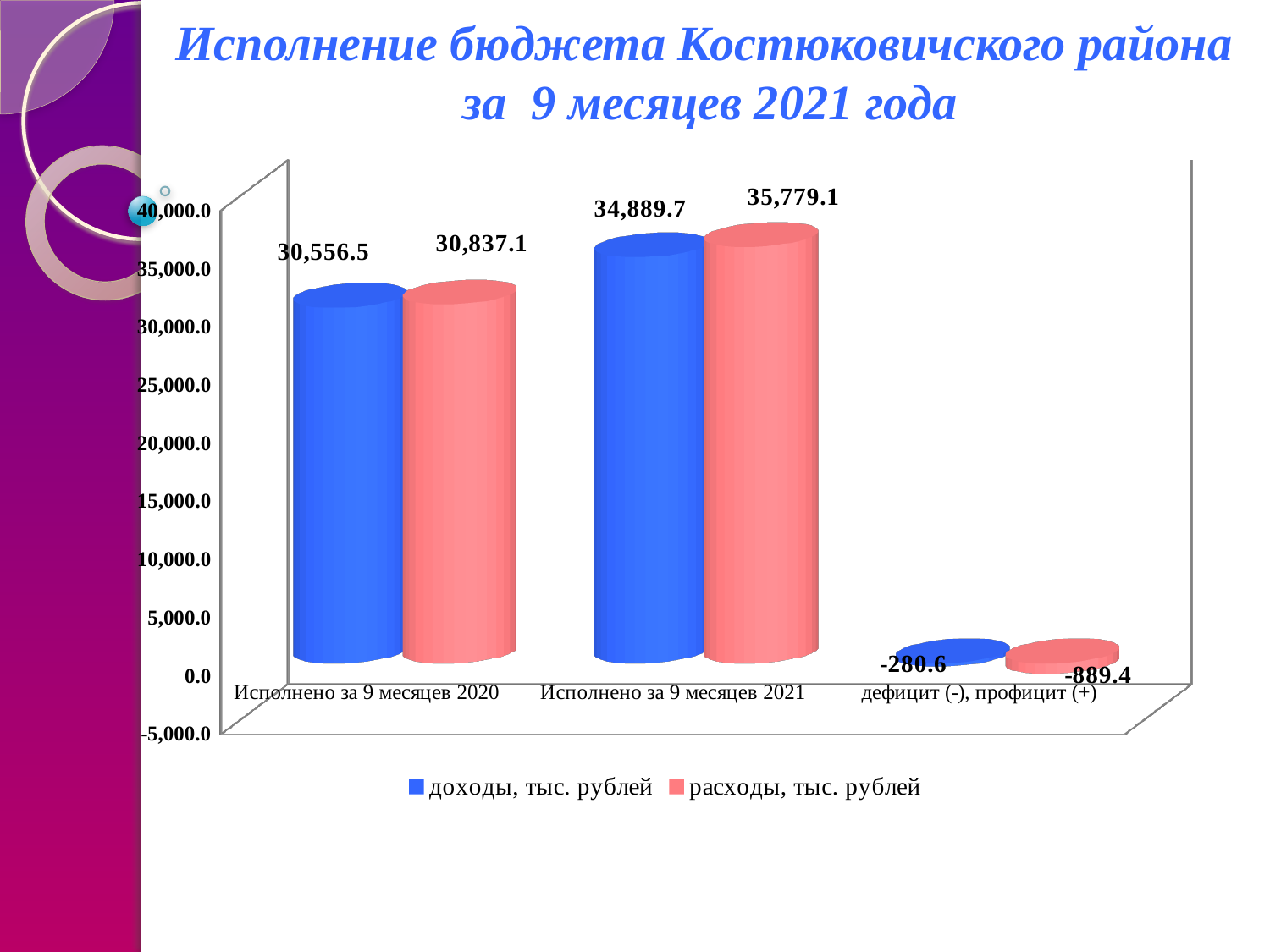
What is the value of расходы, тыс. рублей for Исполнено за 9 месяцев 2020? 30,837.1 How many categories are shown on the x axis? 3 Which is larger: доходы for Исполнено за 9 месяцев 2021 or расходы for Исполнено за 9 месяцев 2020? доходы for Исполнено за 9 месяцев 2021 What is the difference between расходы and доходы for Исполнено за 9 месяцев 2021? 889.4 Which category has the highest value for расходы, тыс. рублей? Исполнено за 9 месяцев 2021 What is the value of доходы, тыс. рублей for Исполнено за 9 месяцев 2020? 30,556.5 Which category has the lowest value for доходы, тыс. рублей? дефицит (-), профицит (+) What kind of chart is shown on the slide? Bar chart What is the value of расходы, тыс. рублей for Исполнено за 9 месяцев 2021? 35,779.1 What is the difference between доходы for Исполнено за 9 месяцев 2021 and Исполнено за 9 месяцев 2020? 4,333.2 How many series does the legend list? 2 What is the value of доходы, тыс. рублей for дефицит (-), профицит (+)? -280.6